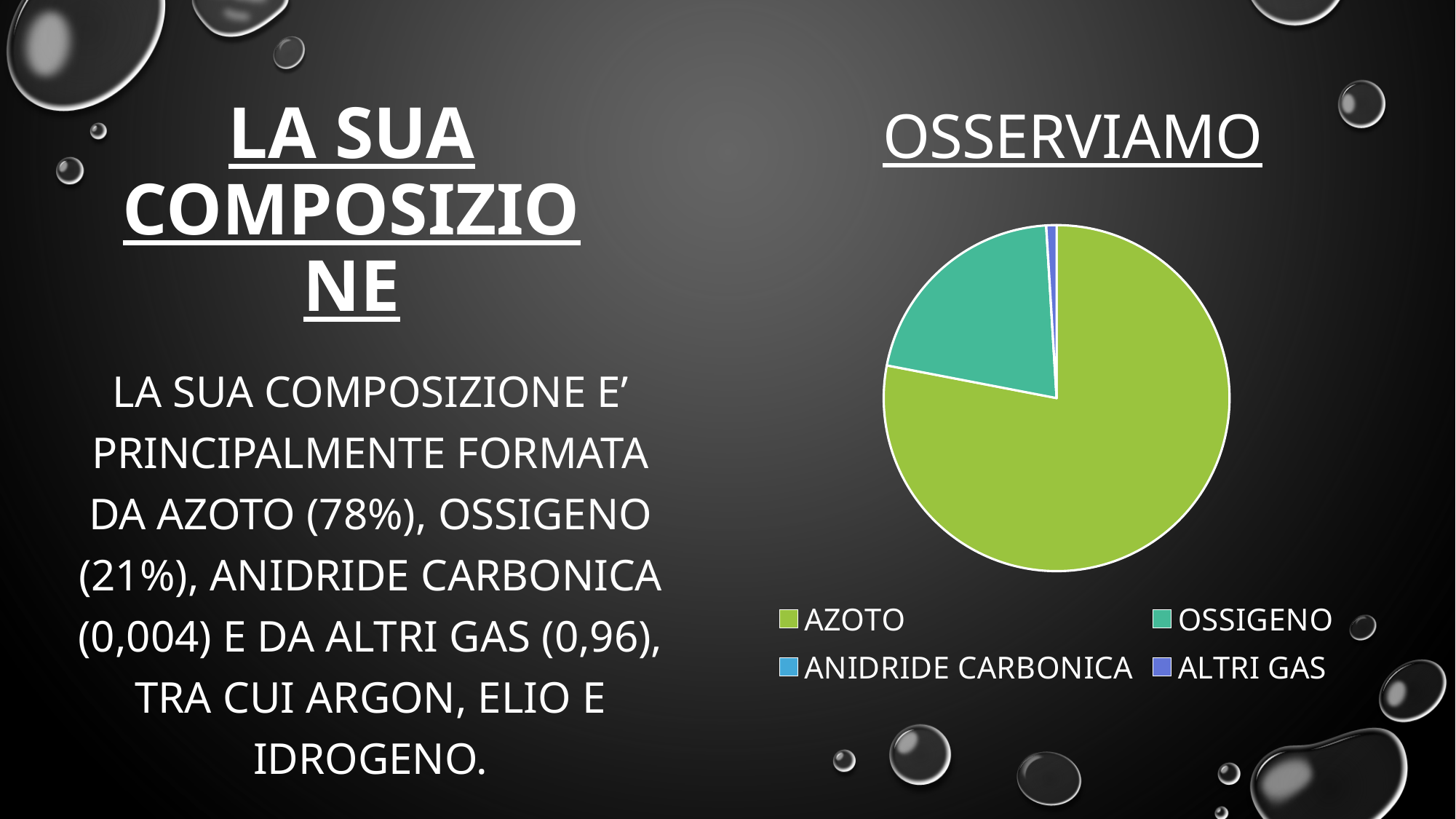
Which slice is larger, AZOTO or OSSIGENO? AZOTO What kind of chart is shown on the slide? pie chart Which category has the second-largest slice of the pie? OSSIGENO Which category has the largest slice of the pie? AZOTO Does the AZOTO slice take up more or less than half of the pie? more Which slice is larger, OSSIGENO or ALTRI GAS? OSSIGENO Which category is shown in green in the pie chart? AZOTO How many categories does the pie chart have? 4 What is the title of the chart? OSSERVIAMO